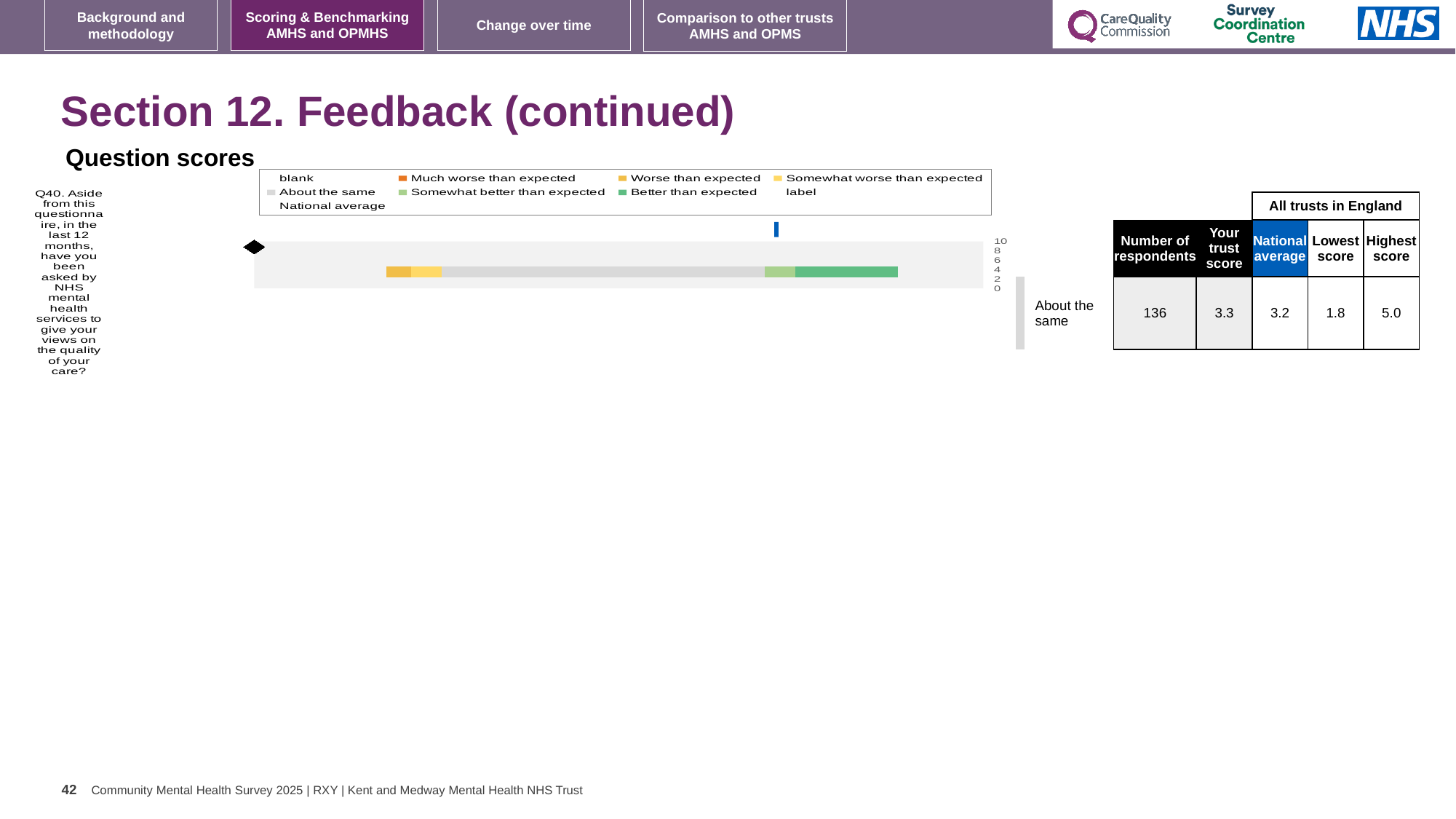
How many questions (categories) are plotted in the Question scores chart? 1 What benchmark category is the trust's Q40 score placed in? About the same Which is larger for Q40: the trust score or the national average? trust score What kind of chart is used to show the Q40 question score? bar chart According to the table, what is the lowest score among all trusts in England for Q40? 1.8 What is the difference between the highest and lowest scores for Q40 among all trusts in England? 3.2 Which question is plotted in the Question scores chart? Q40 According to the table, what is the trust score for Q40? 3.3 In the chart legend, what colour represents 'Better than expected'? green According to the table, what is the national average score for Q40? 3.2 According to the table, what is the highest score among all trusts in England for Q40? 5.0 According to the table, how many respondents answered Q40? 136